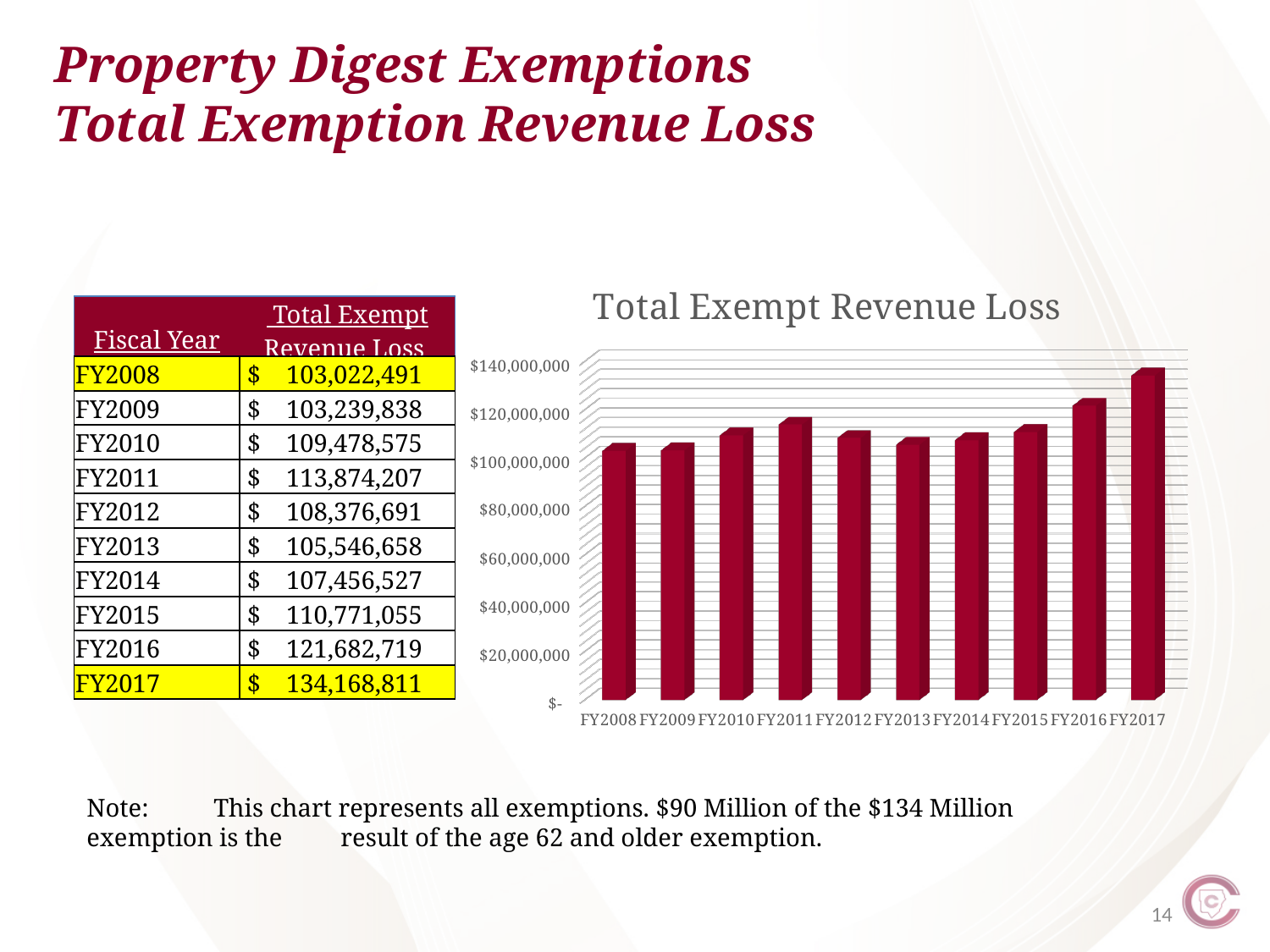
What is the difference between the Total Exempt Revenue Loss in FY2017 and FY2008? $ 31,146,320 What is the Total Exempt Revenue Loss for FY2011? $ 113,874,207 What is the Total Exempt Revenue Loss for FY2016? $ 121,682,719 Which is larger, the Total Exempt Revenue Loss for FY2016 or for FY2015? FY2016 How many fiscal years are plotted in the Total Exempt Revenue Loss chart? 10 What is the Total Exempt Revenue Loss for FY2017? $ 134,168,811 Which is larger, the Total Exempt Revenue Loss for FY2011 or for FY2012? FY2011 What is the title of the chart? Total Exempt Revenue Loss Is the value for FY2017 greater or less than $120,000,000? greater What kind of chart is shown on the slide? bar chart Is the value for FY2013 greater or less than $120,000,000? less Which fiscal year has the highest Total Exempt Revenue Loss? FY2017